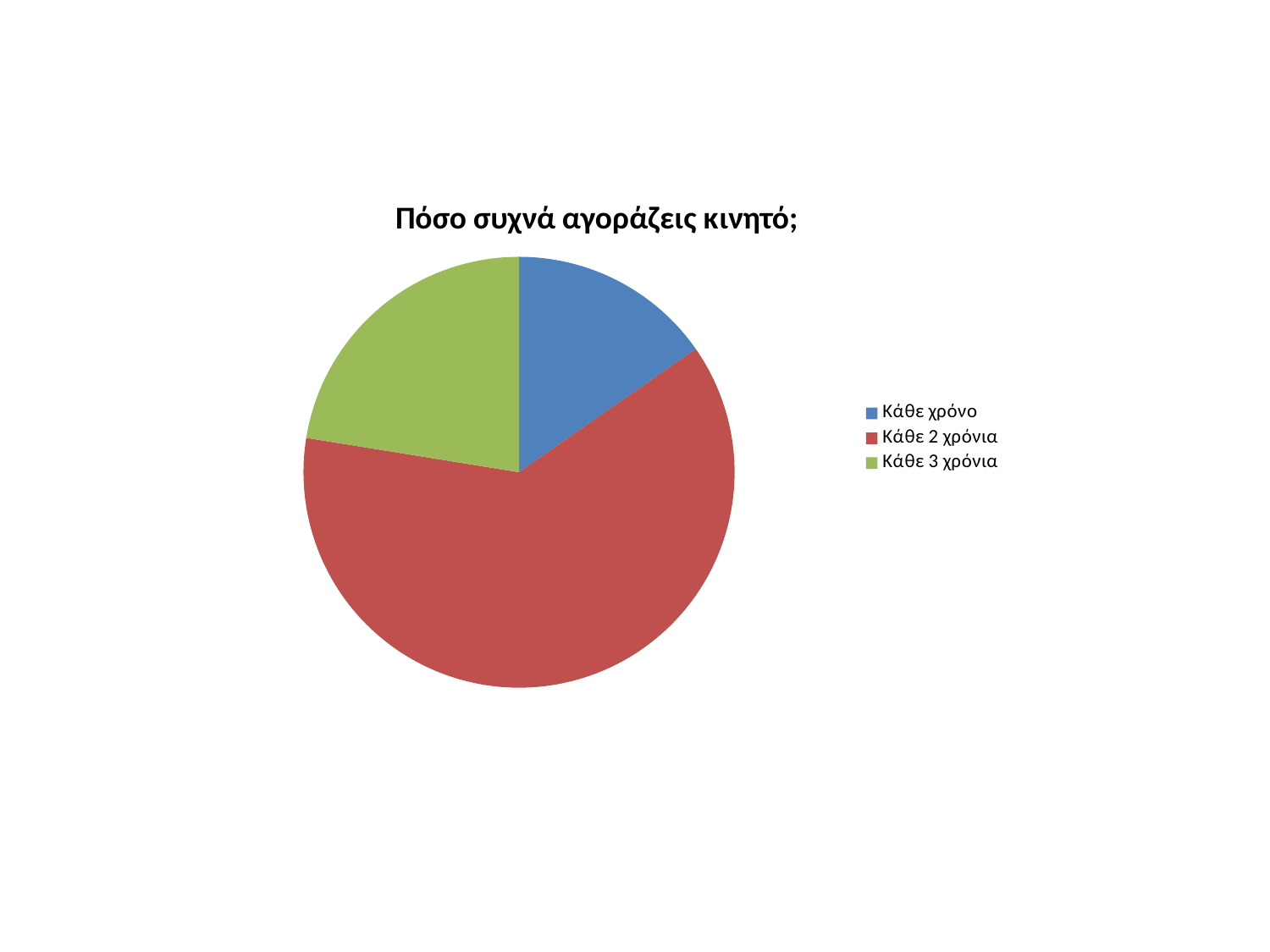
Which slice is larger, Κάθε 2 χρόνια or Κάθε 3 χρόνια? Κάθε 2 χρόνια What kind of chart is shown on the slide? Pie chart How many slices does the pie chart have? 3 Which slice is larger, Κάθε χρόνο or Κάθε 3 χρόνια? Κάθε 3 χρόνια How many entries does the legend list? 3 What is the title of the chart? Πόσο συχνά αγοράζεις κινητό; Does the Κάθε 2 χρόνια slice take up more or less than half of the pie? more What colour is the slice for Κάθε 3 χρόνια? Green Which category has the smallest slice of the pie? Κάθε χρόνο Which category has the largest slice of the pie? Κάθε 2 χρόνια